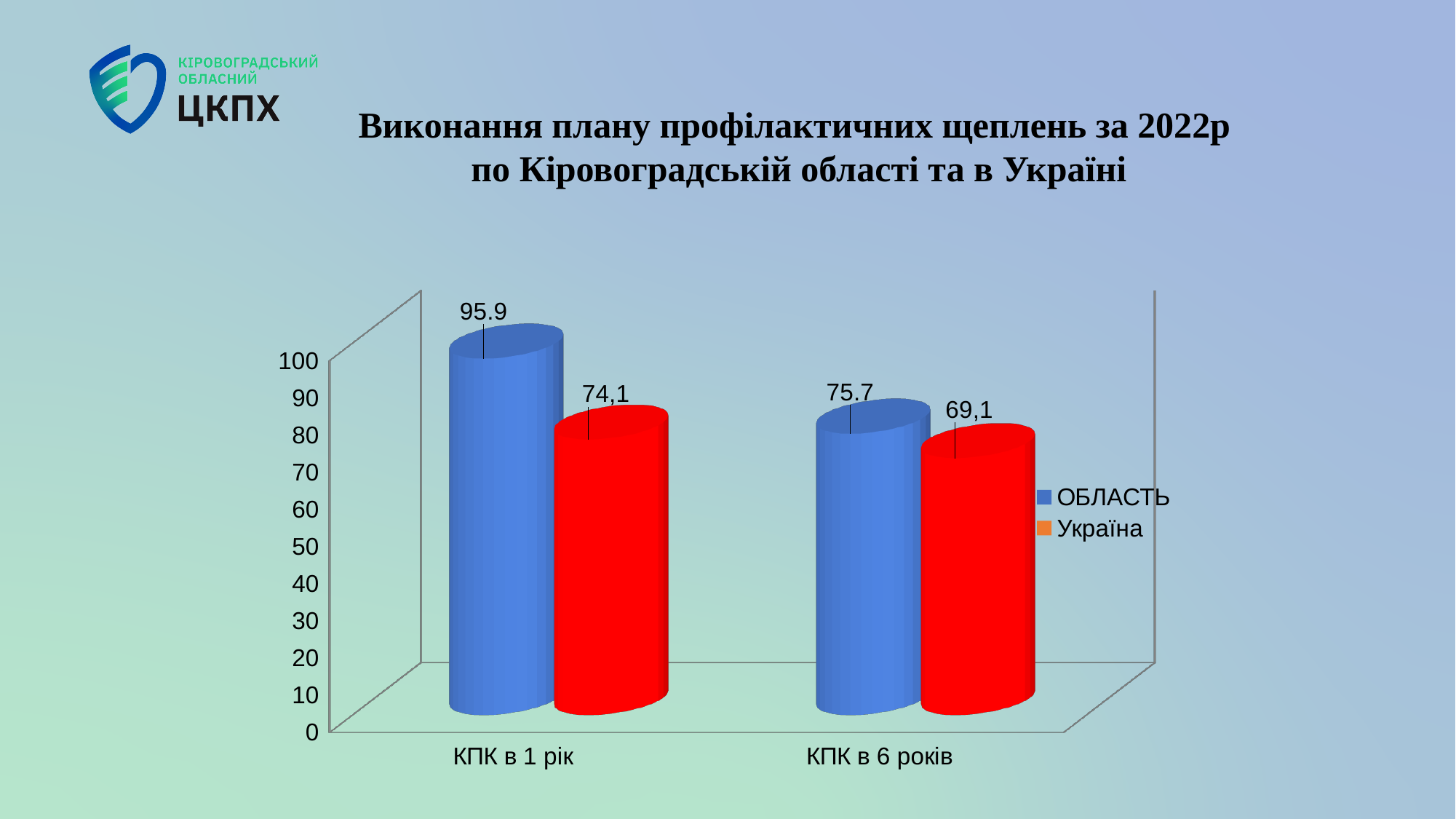
What is the difference between the Україна values for КПК в 1 рік and КПК в 6 років? 5 What is the value for ОБЛАСТЬ in the КПК в 1 рік category? 95.9 In the КПК в 6 років category, which is larger: ОБЛАСТЬ or Україна? ОБЛАСТЬ Which bar has the lowest value on the chart? Україна, КПК в 6 років How many series does the legend list? 2 How many categories are shown on the x axis? 2 What is the value for Україна in the КПК в 6 років category? 69,1 What kind of chart is shown on the slide? Bar chart What is the difference between the ОБЛАСТЬ values for КПК в 1 рік and КПК в 6 років? 20.2 Which bar has the highest value on the chart? ОБЛАСТЬ, КПК в 1 рік What is the value for ОБЛАСТЬ in the КПК в 6 років category? 75.7 What is the value for Україна in the КПК в 1 рік category? 74,1